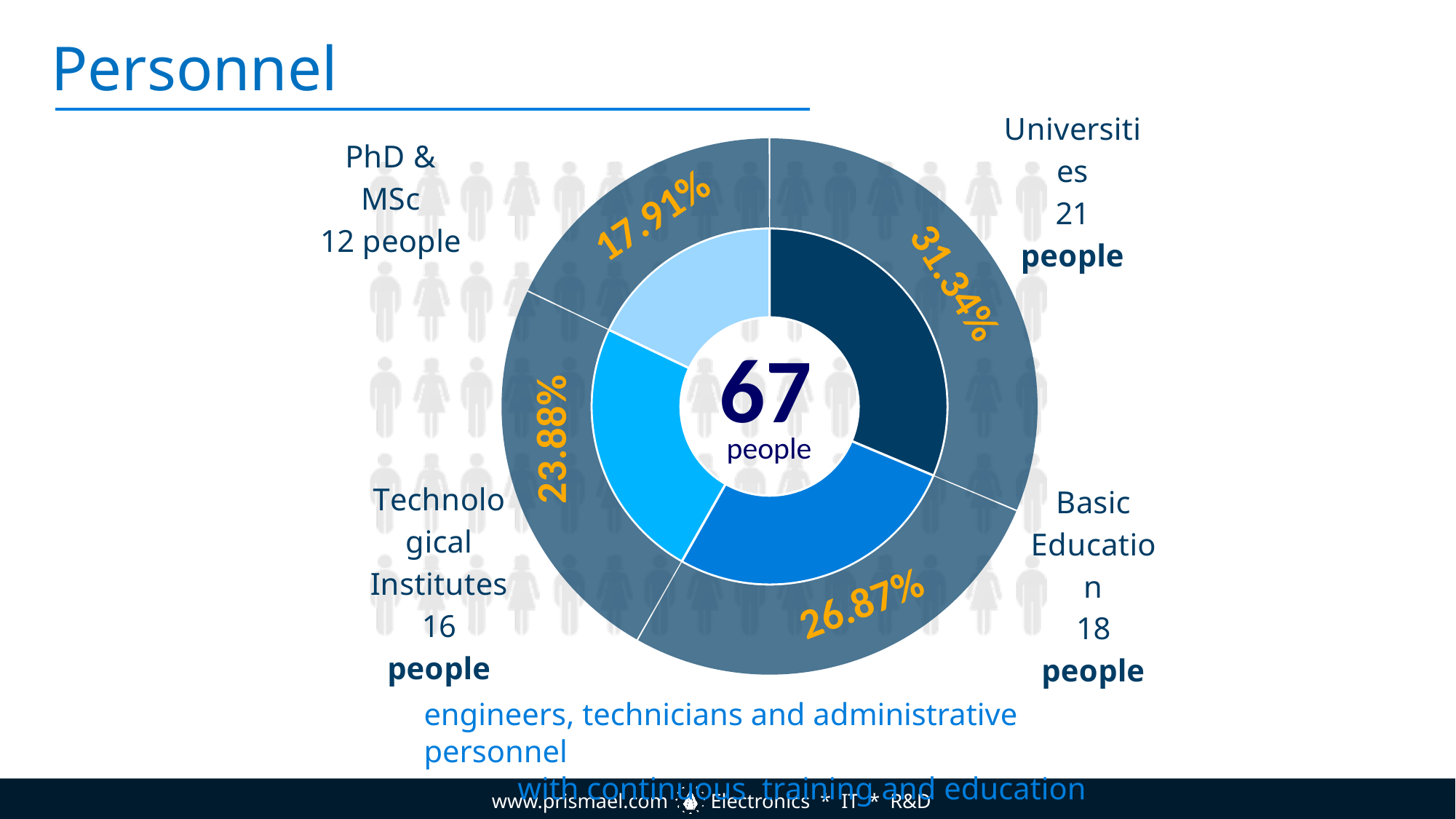
What kind of chart is shown on the slide? Donut (pie) chart How many people are in the Technological Institutes category? 16 How many people are in the Universities category? 21 What percentage share does the PhD & MSc category have? 17.91% What is the title of the slide? Personnel What percentage share does Basic Education have in the chart? 26.87% What is the difference in number of people between Universities and Basic Education? 3 Which category has the smallest share of personnel? PhD & MSc Which has more people, Technological Institutes or PhD & MSc? Technological Institutes How many categories does the chart show? 4 What total number of people is shown in the centre of the chart? 67 Which category has the largest share of personnel? Universities